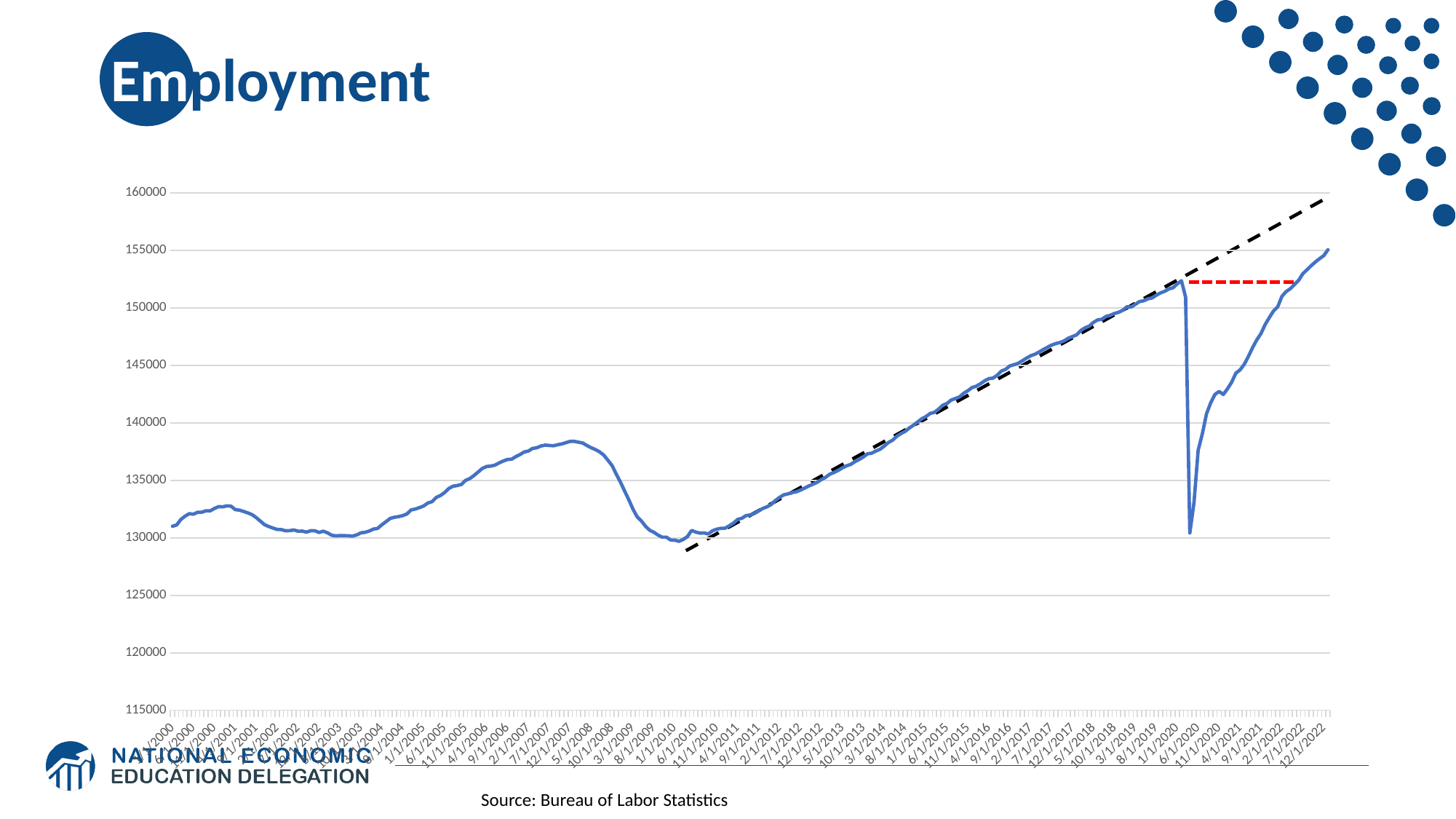
What is the title of the chart on the slide? Employment Does the line rise or fall between 5/1/2008 and 8/1/2009? fall Is the value for 1/1/2010 greater or less than 135000? less Is the value for 1/1/2000 greater or less than 135000? less Is the value for 12/1/2022 greater or less than 150000? greater What is the highest value shown on the vertical axis? 160000 Does the line rise or fall between 1/1/2010 and 8/1/2019? rise What source is cited for the chart? Bureau of Labor Statistics What kind of chart is shown on the slide? line chart Which is larger, the value for 7/1/2007 or the value for 1/1/2000? 7/1/2007